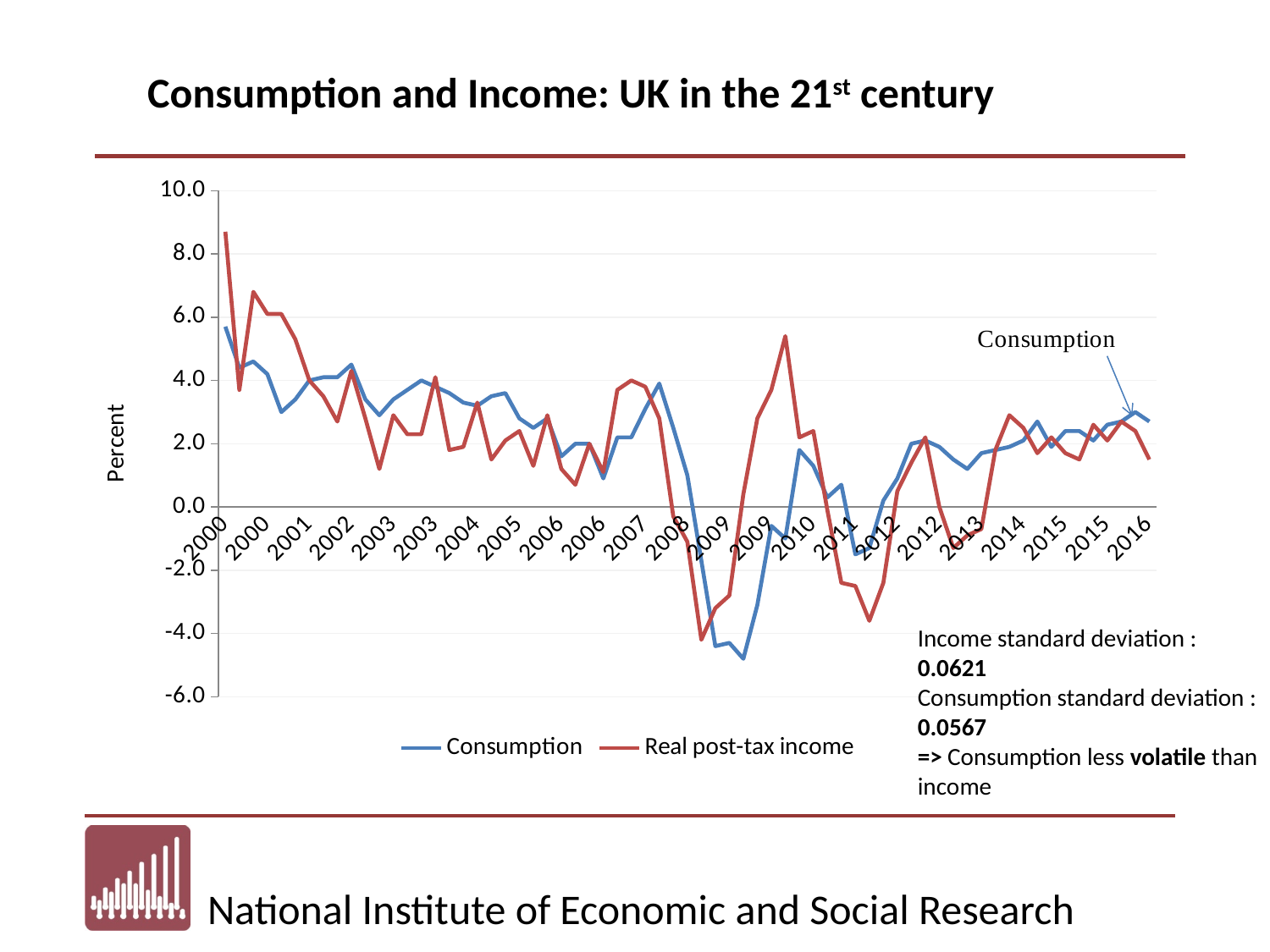
Is the value for Real post-tax income at the start of the series in 2000 greater or less than 8.0? greater At the start of the series in 2000, which is higher: Consumption or Real post-tax income? Real post-tax income Which series reaches the highest value anywhere on the chart? Real post-tax income Is the peak value of Real post-tax income around 2009-2010 greater or less than 4.0? greater What is the title of the chart on the slide? Consumption and Income: UK in the 21st century Is the value for Consumption at the start of the series in 2000 greater or less than 4.0? greater What is the label on the vertical axis of the chart? Percent What kind of chart is shown on the slide? line chart How many series does the legend list? 2 Does the Real post-tax income line generally rise or fall between 2000 and 2003? fall